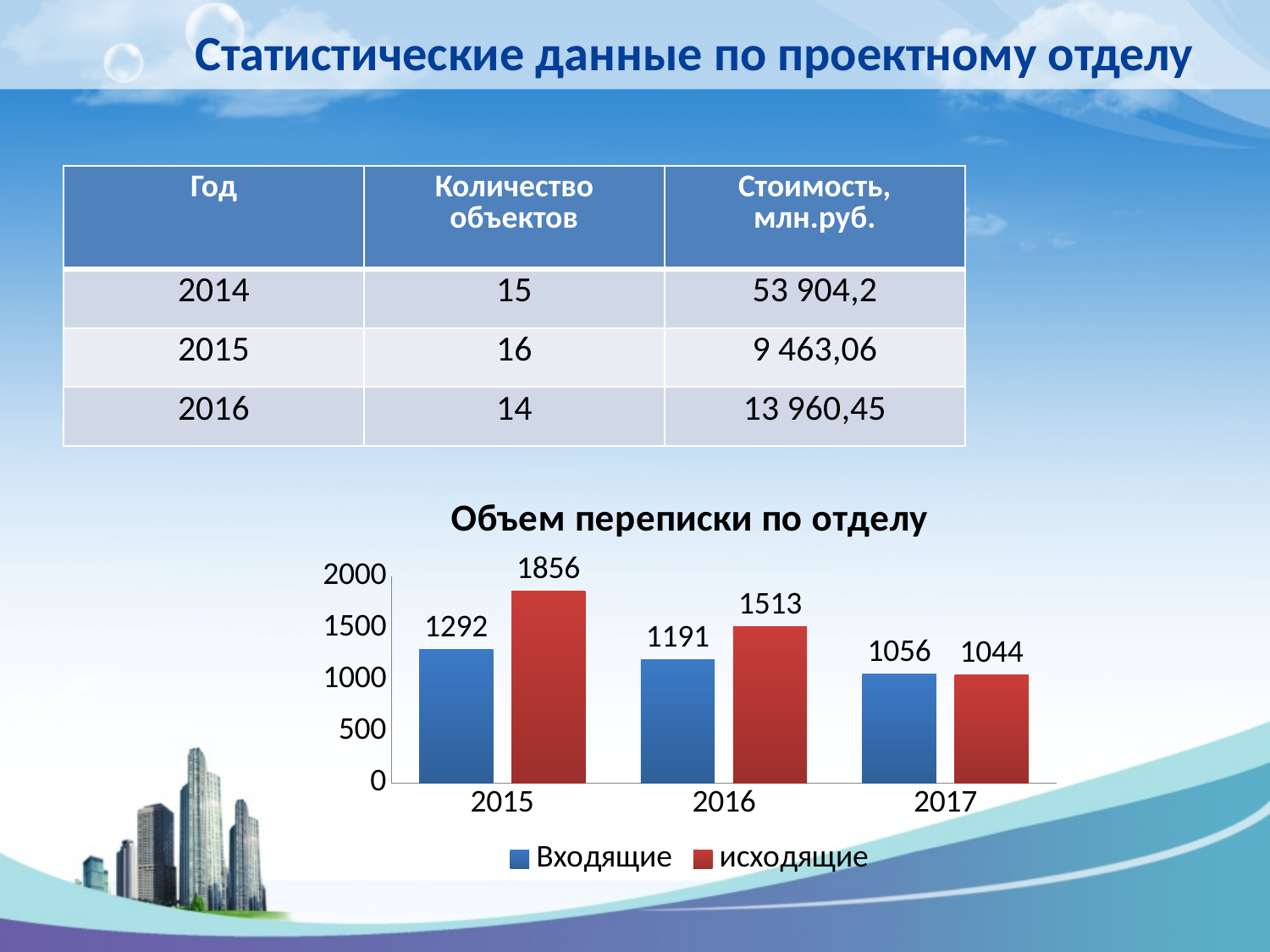
What is the value for Входящие in 2017? 1056 Which year has the lowest value for Входящие? 2017 What is the value for исходящие in 2016? 1513 Which is larger in 2016, Входящие or исходящие? исходящие What is the difference between Входящие in 2015 and Входящие in 2016? 101 What is the difference between исходящие and Входящие in 2015? 564 Which year has the highest value for исходящие? 2015 What is the value for Входящие in 2015? 1292 Do the values for исходящие rise or fall from 2015 to 2017? fall How many series does the chart legend list? 2 How many years are shown on the x axis of the chart? 3 What kind of chart is shown on the slide? bar chart